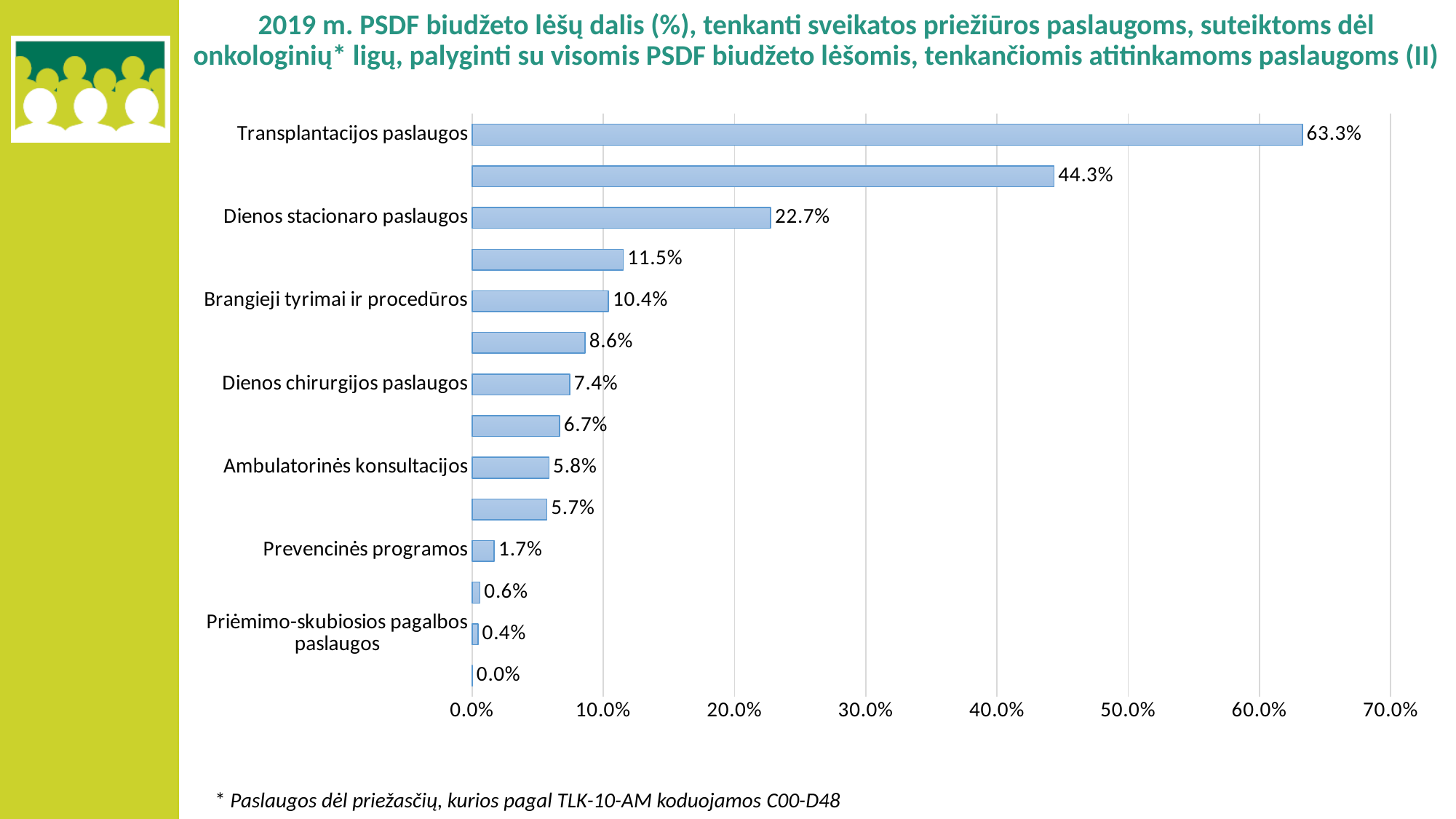
What is the difference between the values for Transplantacijos paslaugos and Dienos stacionaro paslaugos? 40.6 percentage points What kind of chart is shown on the slide? Bar chart What is the value for Priėmimo-skubiosios pagalbos paslaugos? 0.4% How many bars are plotted on the chart? 14 Which is larger, the value for Dienos chirurgijos paslaugos or the value for Prevencinės programos? Dienos chirurgijos paslaugos Is the value for Dienos stacionaro paslaugos greater or less than 20.0%? greater Which labelled category has the highest value? Transplantacijos paslaugos What is the value for Dienos stacionaro paslaugos? 22.7% What is the value for Ambulatorinės konsultacijos? 5.8% What is the value for Brangieji tyrimai ir procedūros? 10.4% What is the smallest value printed on the chart? 0.0% What is the value for Transplantacijos paslaugos? 63.3%